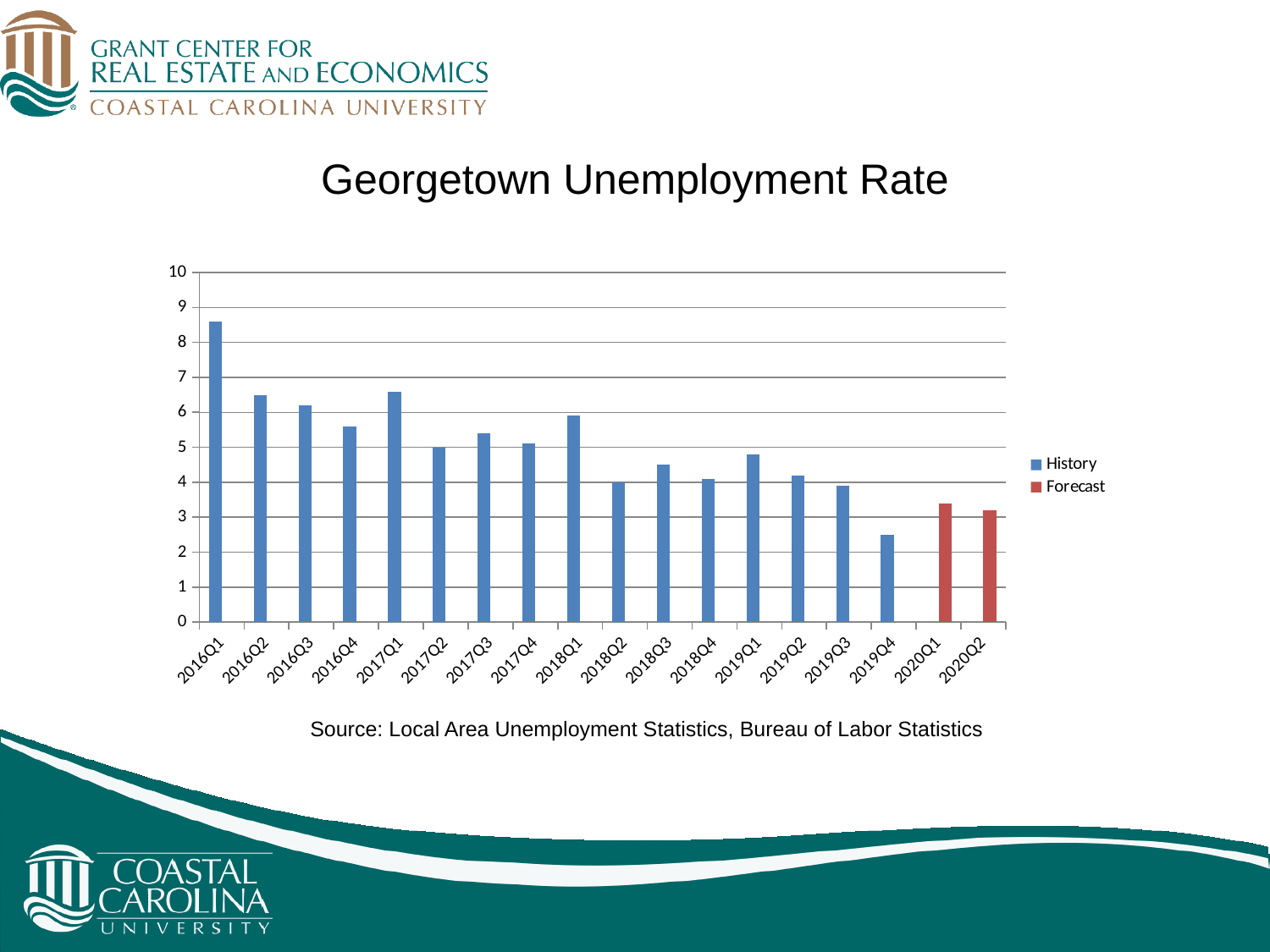
Is the value for 2019Q4 greater or less than 3? less How many series does the legend list? 2 Is the value for 2016Q1 greater or less than 8? greater How many quarters are shown on the x axis? 18 Do the unemployment rate values generally rise or fall from 2016Q1 to 2019Q4? fall What type of chart is shown on the slide? bar chart Is the value for 2020Q1 greater or less than 3? greater Which quarter has the highest unemployment rate? 2016Q1 Which is larger, the value for 2018Q1 or the value for 2018Q2? 2018Q1 What is the title of the chart? Georgetown Unemployment Rate Which quarter has the lowest unemployment rate? 2019Q4 What are the two series named in the legend? History and Forecast